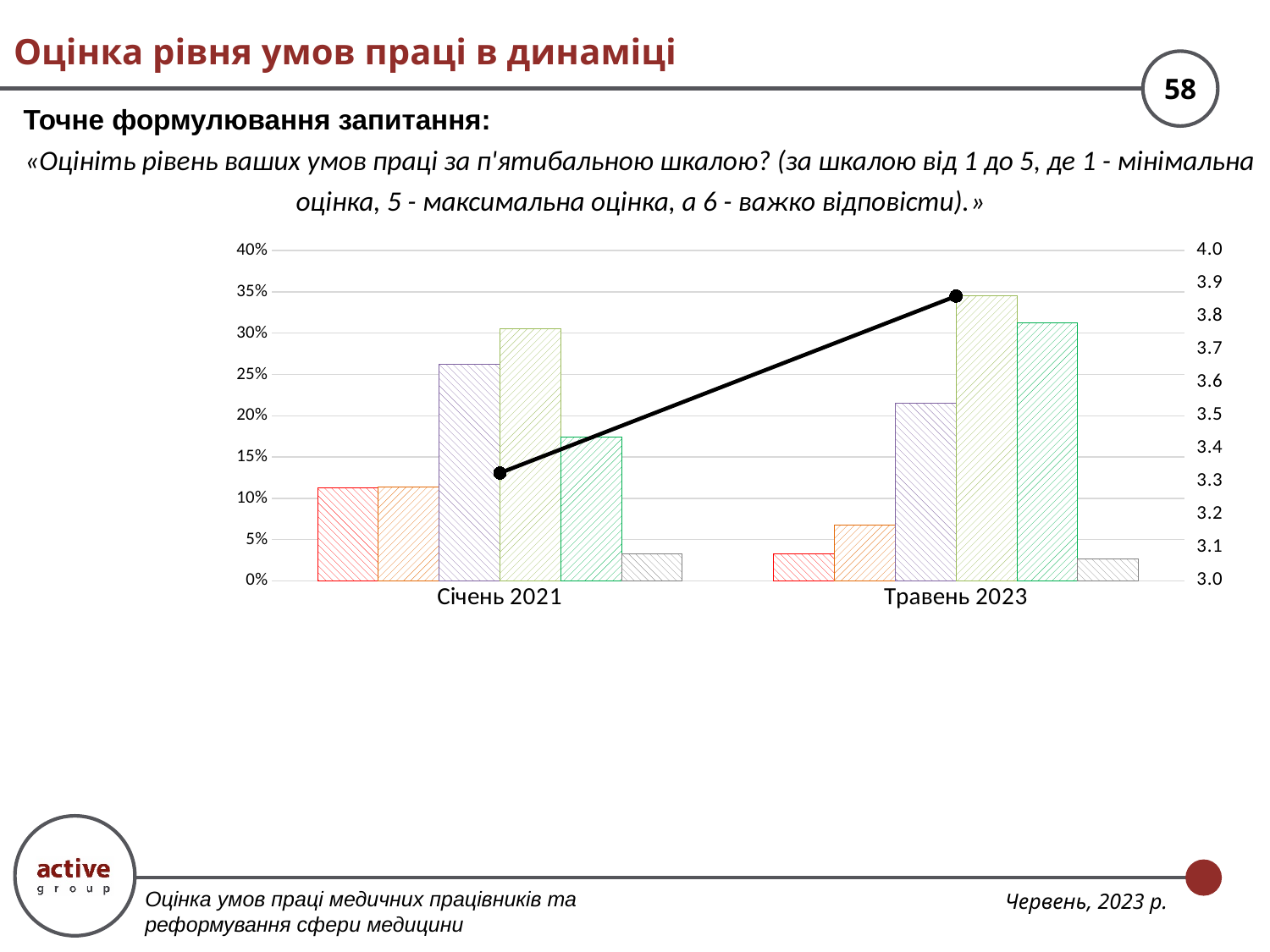
What are the two categories on the x axis of the chart? Січень 2021 and Травень 2023 Is the line value for Травень 2023 greater or less than 3.8 on the right axis? greater Is the tallest bar in the Січень 2021 group greater or less than 35%? less What kind of chart is shown on the slide? bar chart with a line Does the line in the chart rise or fall from Січень 2021 to Травень 2023? rises Is the line value for Січень 2021 greater or less than 3.4 on the right axis? less How many categories are shown on the x axis of the chart? 2 For which category is the line value higher, Січень 2021 or Травень 2023? Травень 2023 How many bars are plotted for each category in the chart? 6